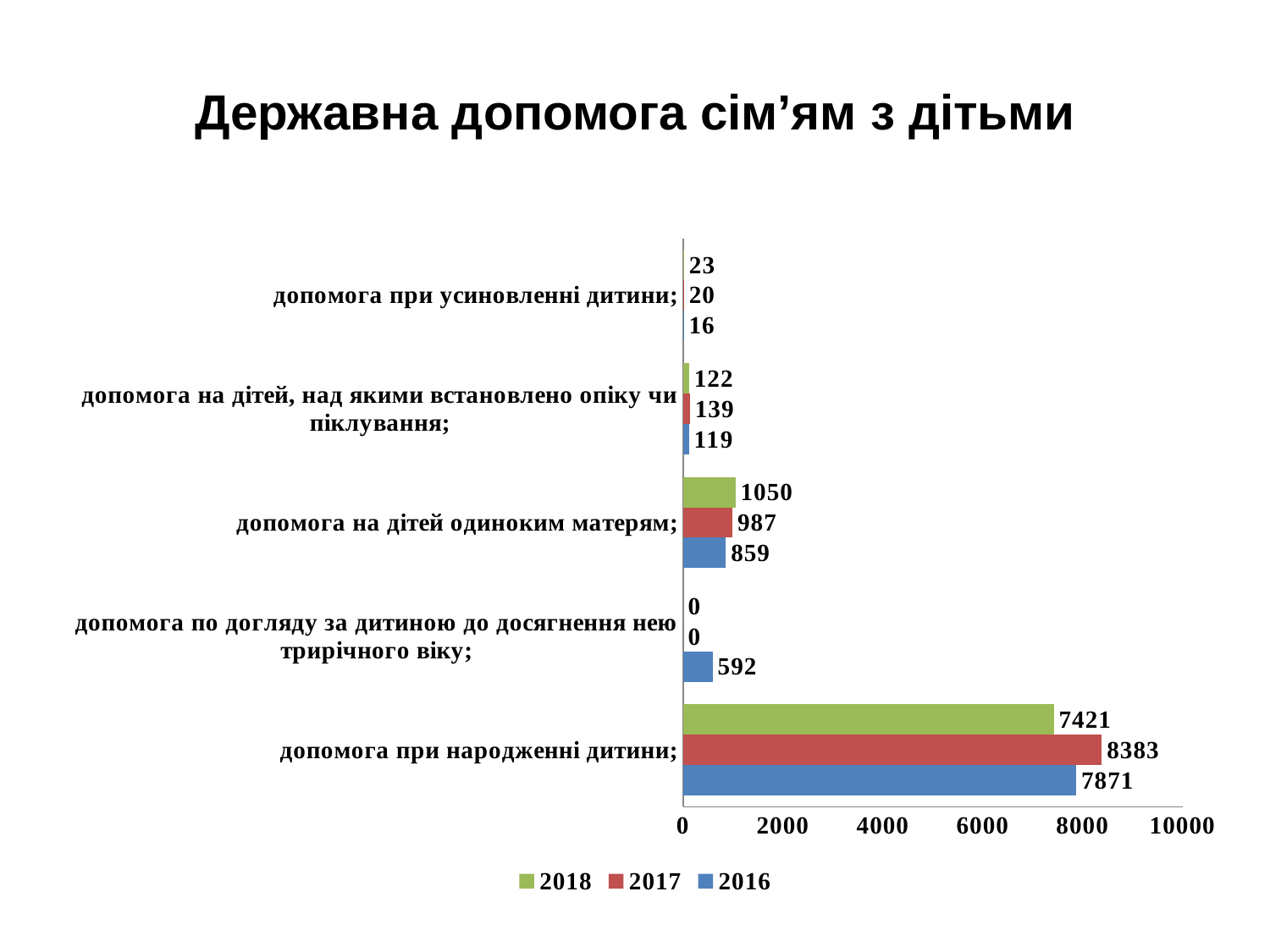
What is the 2017 value for "допомога при народженні дитини"? 8383 What is the 2018 value for "допомога на дітей одиноким матерям"? 1050 What is the difference between the 2017 and 2016 values for "допомога при народженні дитини"? 512 What is the 2017 value for "допомога на дітей, над якими встановлено опіку чи піклування"? 139 Which is larger for "допомога на дітей одиноким матерям": the 2017 value or the 2016 value? 2017 How many series does the legend list? 3 What type of chart is shown on the slide? bar chart How many categories are shown on the chart? 5 What is the title of the slide? Державна допомога сім’ям з дітьми Which category has the lowest 2016 value? допомога при усиновленні дитини What is the 2016 value for "допомога по догляду за дитиною до досягнення нею трирічного віку"? 592 Which category has the highest 2018 value? допомога при народженні дитини